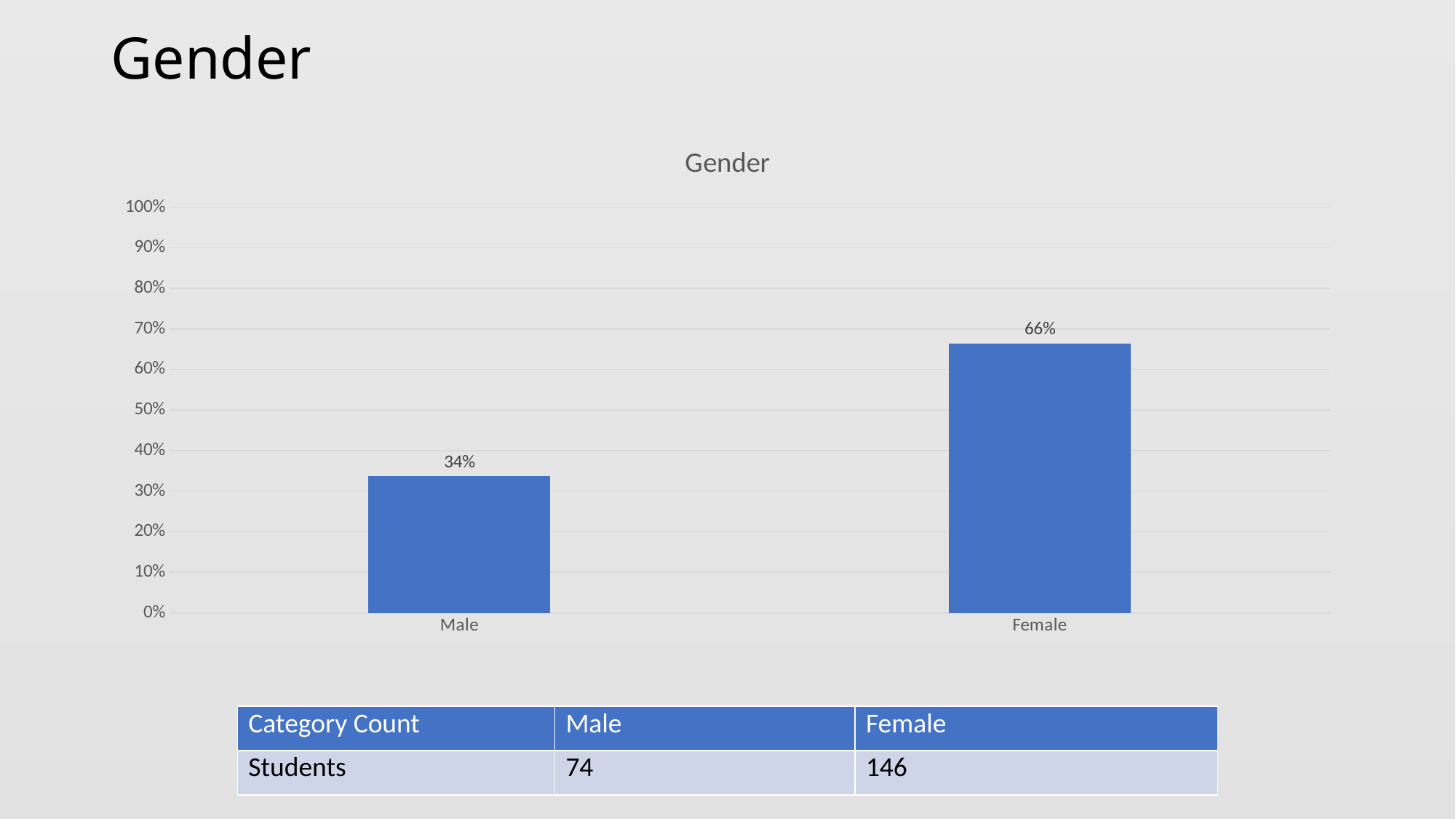
What is the difference between the Female and Male values in the Gender chart? 32% What kind of chart is the Gender chart? bar chart Which category has the highest value in the Gender chart? Female What is the title of the chart on the slide? Gender Is the value for Female in the Gender chart greater or less than 60%? greater Which is larger in the Gender chart, the value for Male or the value for Female? Female What is the value for Male in the Gender chart? 34% How many categories are shown in the Gender chart? 2 Which category has the lowest value in the Gender chart? Male What is the highest value shown on the y axis of the Gender chart? 100% Is the value for Male in the Gender chart greater or less than 40%? less What is the value for Female in the Gender chart? 66%